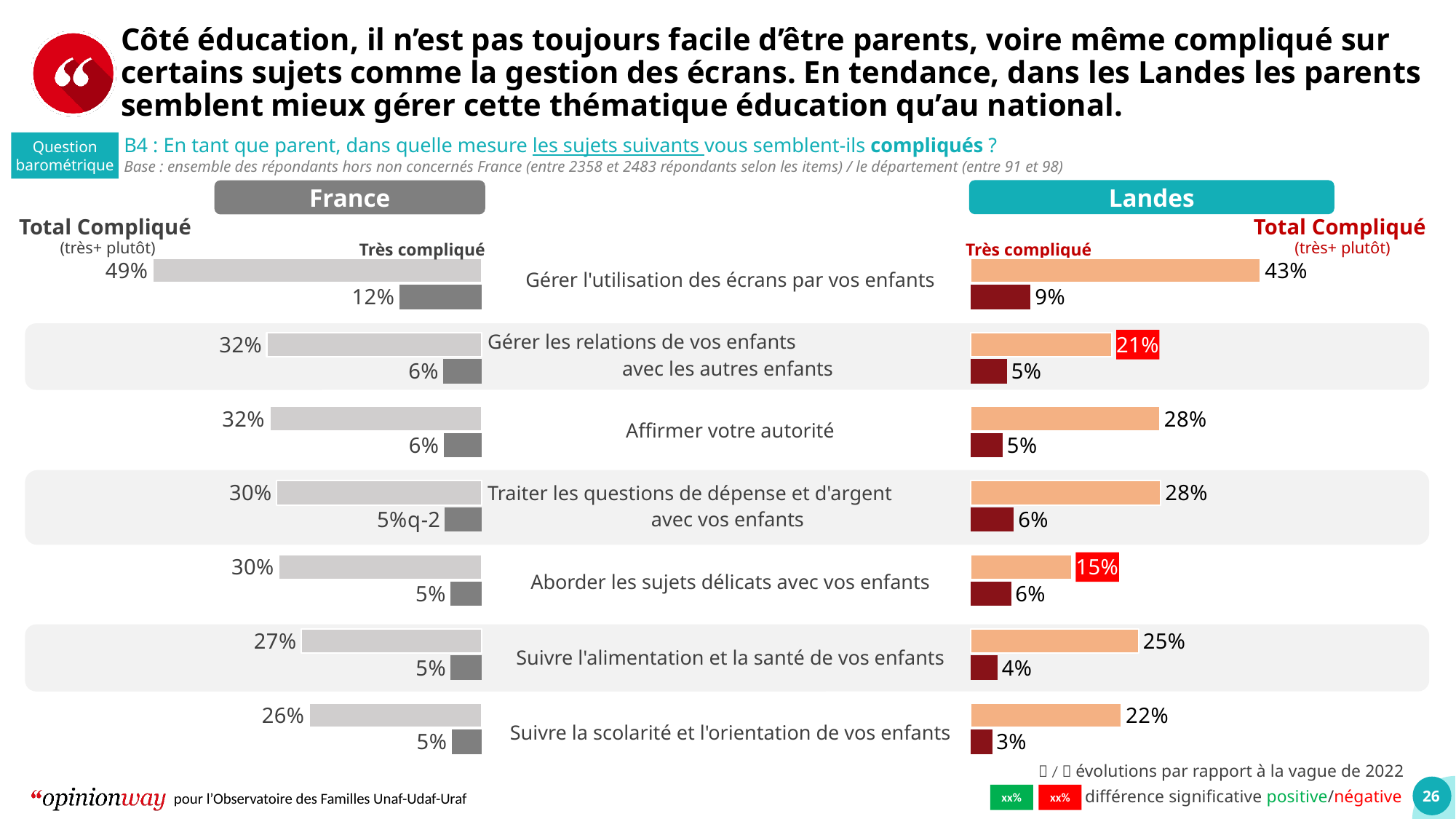
How many items are listed in the France chart? 7 How many series does each chart show (Total Compliqué and Très compliqué)? 2 In the France chart, which item has the highest Total Compliqué value? Gérer l'utilisation des écrans par vos enfants In the Landes chart, what is the Total Compliqué value for "Affirmer votre autorité"? 28% In the Landes chart, which item has the lowest Très compliqué value? Suivre la scolarité et l'orientation de vos enfants In the France chart, what is the Total Compliqué value for "Gérer l'utilisation des écrans par vos enfants"? 49% In the Landes chart, what is the Très compliqué value for "Gérer l'utilisation des écrans par vos enfants"? 9% In the Landes chart, what colour are the Très compliqué bars? Dark red For "Aborder les sujets délicats avec vos enfants", is the Total Compliqué value larger in France or in Landes? France In the Landes chart, which item has the lowest Total Compliqué value? Aborder les sujets délicats avec vos enfants What is the difference between the France and Landes Total Compliqué values for "Gérer les relations de vos enfants avec les autres enfants"? 11 points What type of chart is used for the France and Landes data? Bar chart